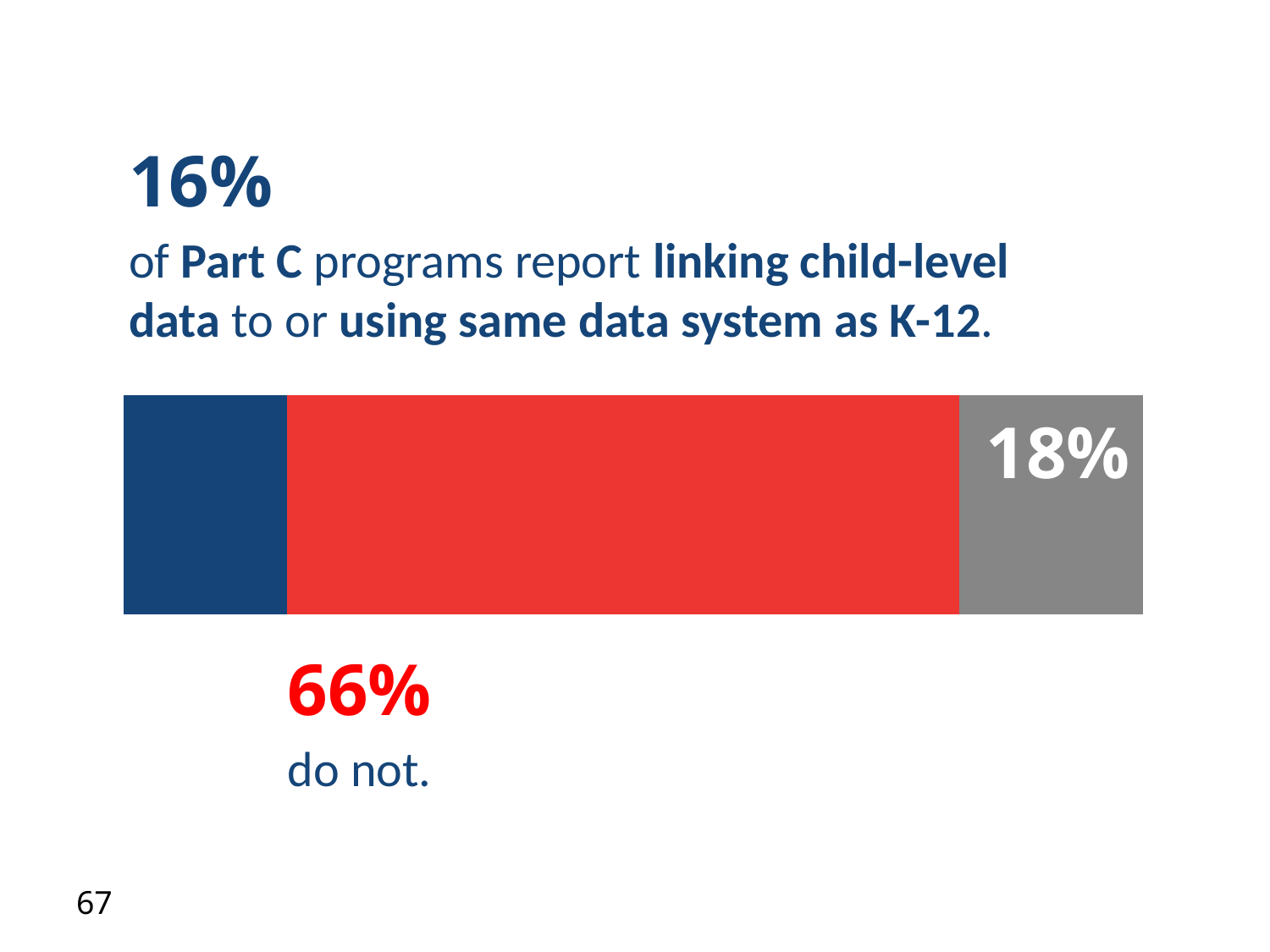
What kind of chart is shown on the slide? A stacked bar chart What is the total of the three segments in the stacked bar? 100% What value is printed on the gray segment of the bar? 18% What percentage of Part C programs report linking child-level data to or using the same data system as K-12? 16% Which segment of the bar is the largest? The red segment (66%) Which is larger, the red segment or the gray segment? The red segment What is the difference between the share that do not link data (66%) and the share that do (16%)? 50 percentage points What colour is the segment representing the 66% that do not link data? Red What percentage of Part C programs do not link child-level data to or use the same data system as K-12? 66% Which segment of the bar is the smallest? The blue segment (16%) Which is larger, the gray segment or the blue segment? The gray segment How many segments make up the stacked bar? 3